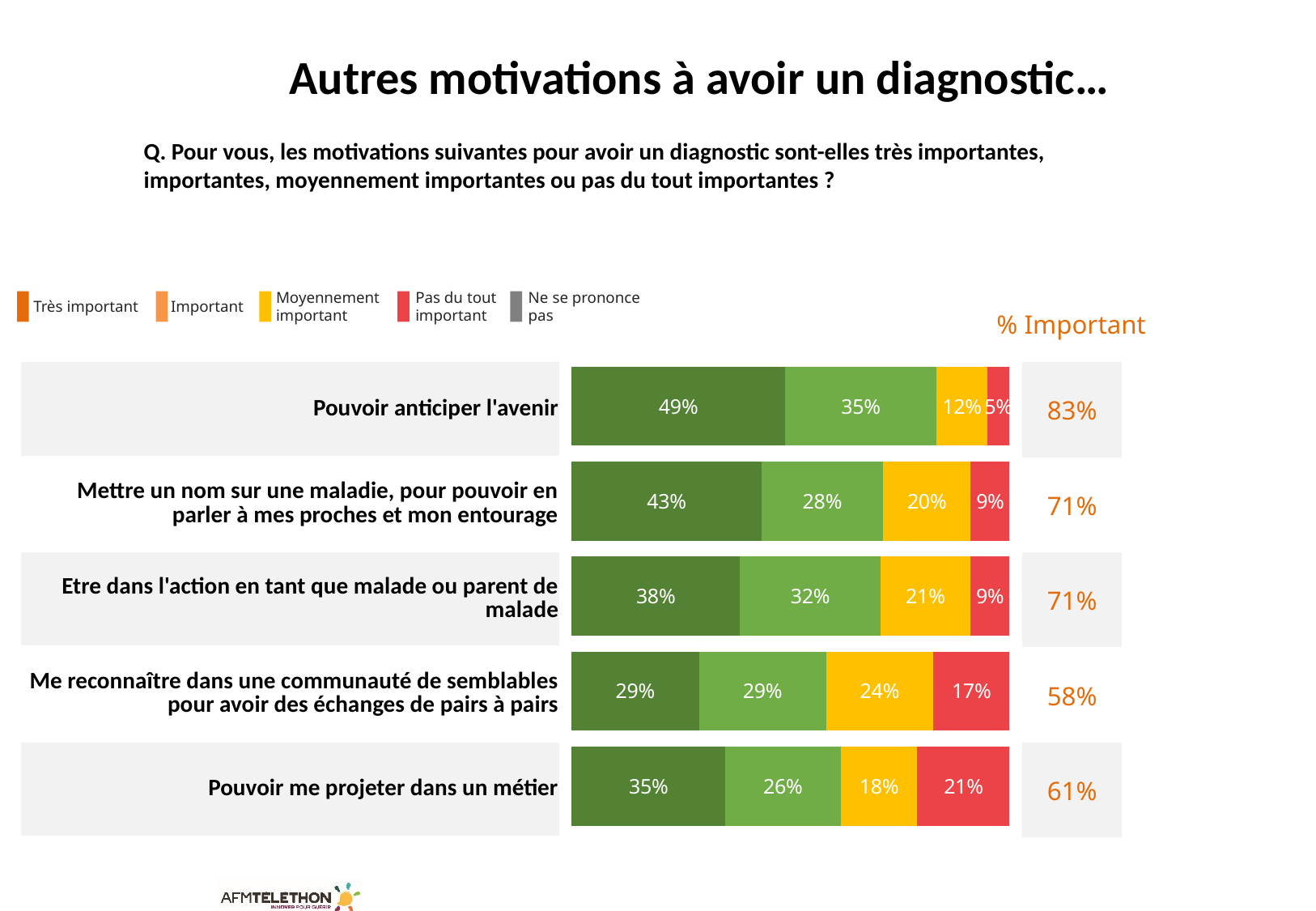
How many motivations (categories) are shown in the chart? 5 What percentage of respondents rated "Me reconnaître dans une communauté de semblables pour avoir des échanges de pairs à pairs" as "Pas du tout important"? 17% What is the "% Important" value shown for "Pouvoir me projeter dans un métier"? 61% What is the difference between the "Très important" percentages for "Pouvoir anticiper l'avenir" and "Pouvoir me projeter dans un métier"? 14% What percentage of respondents rated "Pouvoir anticiper l'avenir" as "Très important"? 49% Which motivation has the highest "% Important" value? Pouvoir anticiper l'avenir What is the title of the slide? Autres motivations à avoir un diagnostic… Which has a larger "Pas du tout important" share: "Pouvoir me projeter dans un métier" or "Me reconnaître dans une communauté de semblables pour avoir des échanges de pairs à pairs"? Pouvoir me projeter dans un métier How many response categories does the legend list? 5 What kind of chart is shown on the slide? Stacked bar chart What percentage of respondents rated "Etre dans l'action en tant que malade ou parent de malade" as "Moyennement important"? 21% Which motivation has the lowest "% Important" value? Me reconnaître dans une communauté de semblables pour avoir des échanges de pairs à pairs